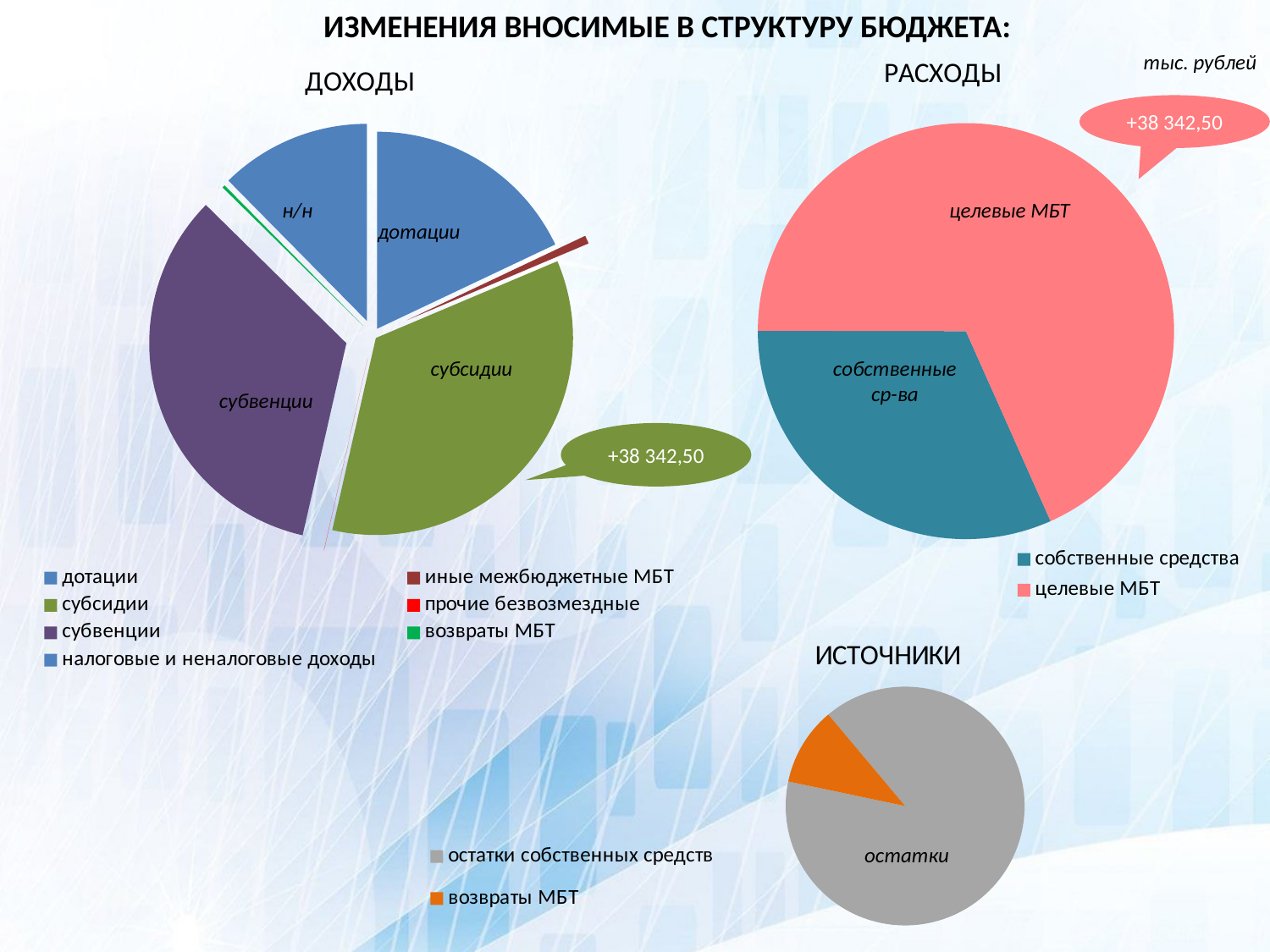
What kind of chart is the ДОХОДЫ chart? pie chart What kind of chart is the ИСТОЧНИКИ chart? pie chart In the ДОХОДЫ chart, which slice is larger: дотации or субвенции? субвенции In the ДОХОДЫ chart, which slice is the largest? субсидии In the РАСХОДЫ chart, which slice is the largest? целевые МБТ How many entries does the legend of the ДОХОДЫ chart list? 7 What change value is shown in the callout pointing to the субсидии slice of the ДОХОДЫ chart? +38 342,50 In the ИСТОЧНИКИ chart, which slice is the smallest? возвраты МБТ What unit is stated for the values on the slide? тыс. рублей In the РАСХОДЫ chart, which slice is larger: собственные средства or целевые МБТ? целевые МБТ How many entries does the legend of the РАСХОДЫ chart list? 2 How many entries does the legend of the ИСТОЧНИКИ chart list? 2